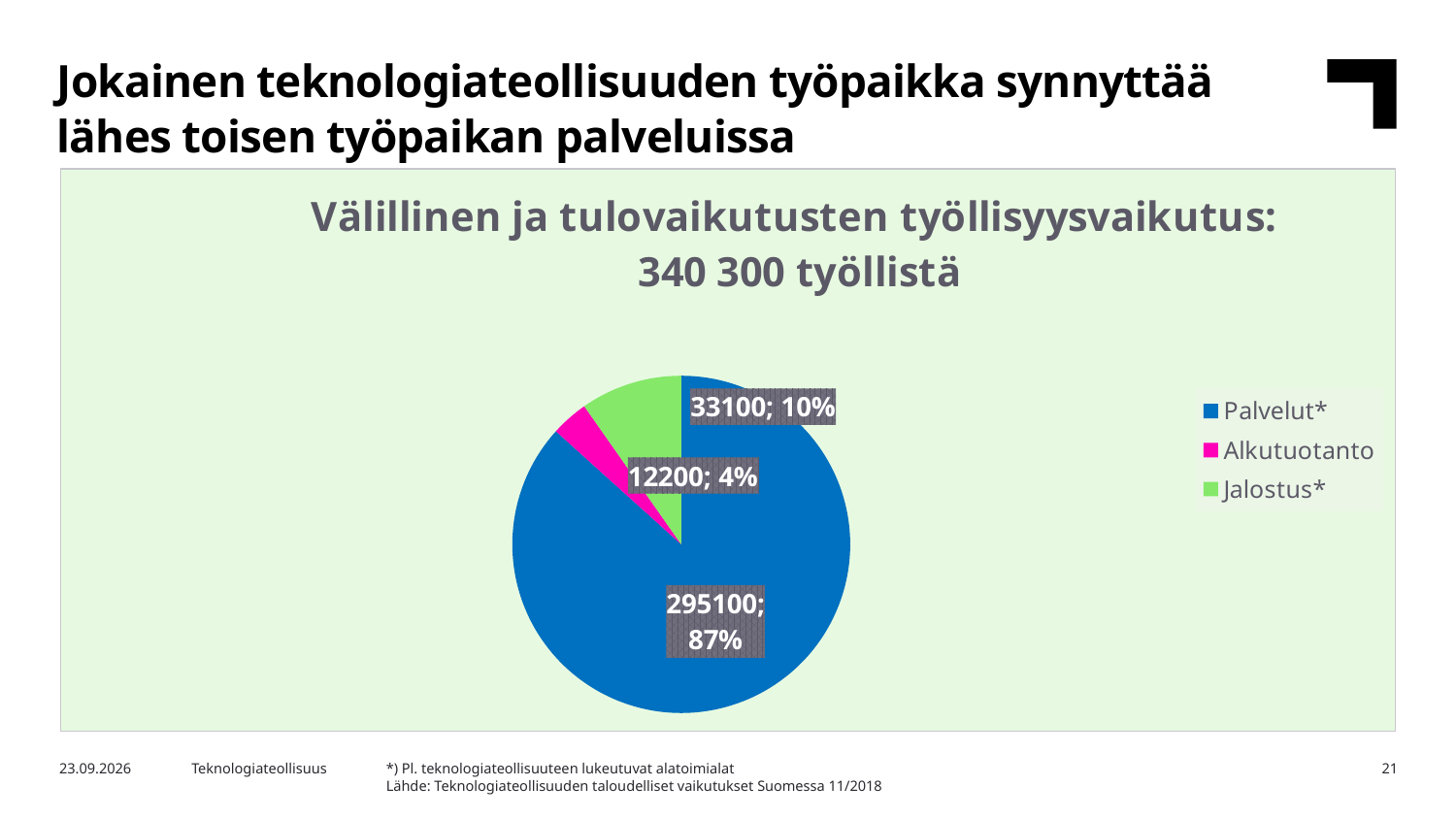
Which category has the smallest slice in the pie chart? Alkutuotanto What is the difference between the values for Jalostus* and Alkutuotanto? 20900 Which category has the largest slice in the pie chart? Palvelut* What share of the pie does Alkutuotanto represent? 4% What kind of chart is shown on the slide? Pie chart What is the title of the chart? Välillinen ja tulovaikutusten työllisyysvaikutus: 340 300 työllistä What is the value for Palvelut* in the pie chart? 295100 What is the value for Jalostus* in the pie chart? 33100 What is the value for Alkutuotanto in the pie chart? 12200 How many slices does the pie chart have? 3 What share of the pie does Palvelut* represent? 87% What share of the pie does Jalostus* represent? 10%